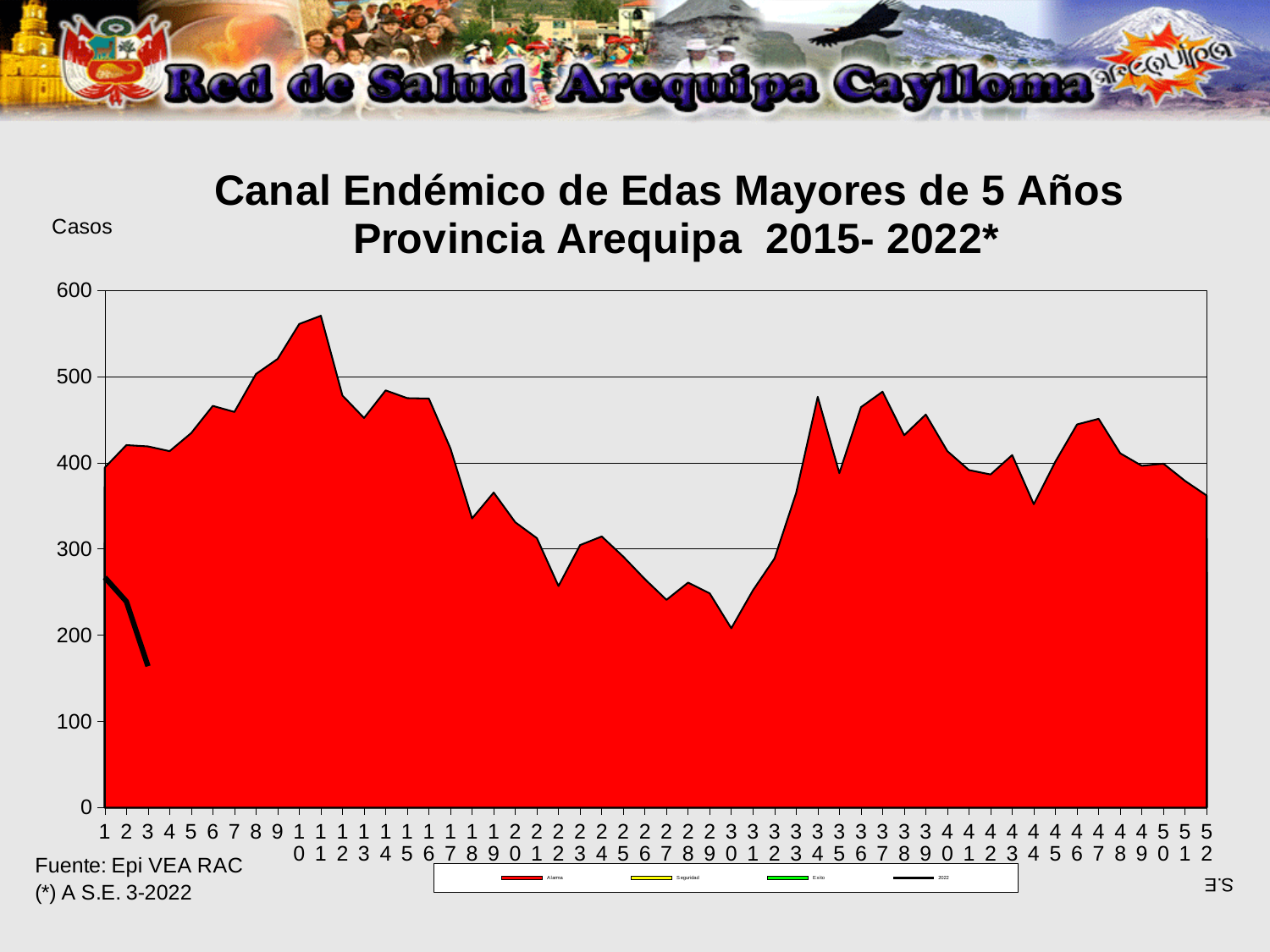
At which week does the red Alarma area reach its lowest value? Week 30 Is the value of the red Alarma area at week 30 greater or less than 300? less Is the value of the black 2022 line at week 3 greater or less than 200? less Is the value of the red Alarma area at week 11 greater or less than 500? greater Does the black 2022 line rise or fall from week 1 to week 3? Fall How many series does the legend list? 4 What label is shown on the vertical axis of the chart? Casos What kind of chart is shown on the slide? Area chart What is the title of the chart? Canal Endémico de Edas Mayores de 5 Años Provincia Arequipa 2015- 2022* Which is larger, the red Alarma value at week 11 or at week 30? Week 11 At which week does the red Alarma area reach its highest value? Week 11 How many epidemiological weeks are shown along the x axis? 52